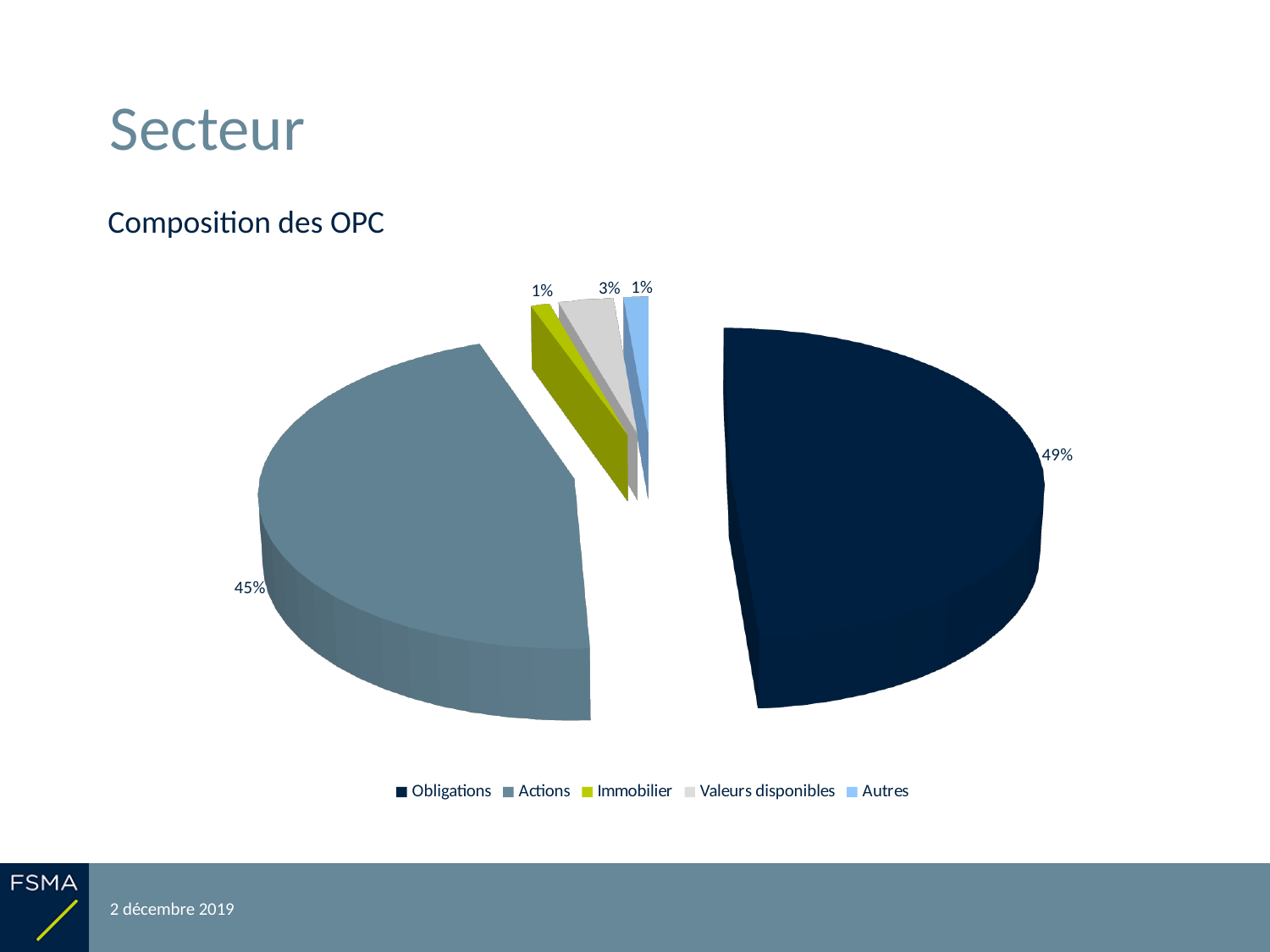
What share of the pie does Valeurs disponibles represent? 3% Which category has the largest slice of the pie? Obligations Which is larger, the share for Actions or the share for Valeurs disponibles? Actions What is the combined share of Obligations and Actions? 94% How many categories does the legend list? 5 Which category is shown in green in the legend? Immobilier What kind of chart is shown on the slide? Pie chart What is the title of the chart? Composition des OPC What share of the pie does Actions represent? 45% What share of the pie does Immobilier represent? 1% What is the difference in percentage points between Obligations and Actions? 4